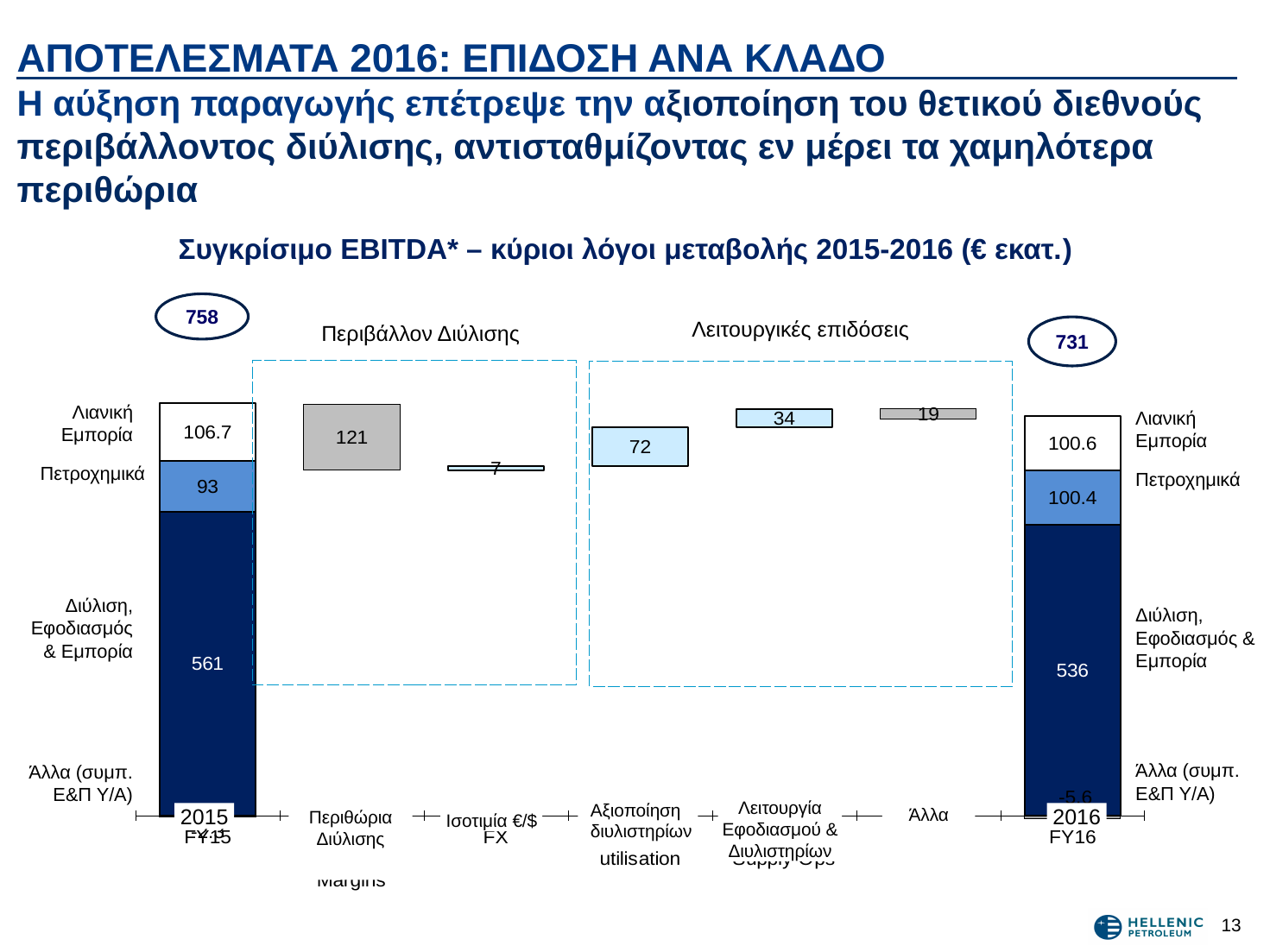
What is the value of the Διύλιση, Εφοδιασμός & Εμπορία segment in the 2016 bar? 536 Which bridge item has the smallest value? Ισοτιμία €/$ What is the value of the Πετροχημικά segment in the 2016 bar? 100.4 By how much did the Διύλιση, Εφοδιασμός & Εμπορία segment change from 2015 (561) to 2016 (536)? 25 What is the value shown for Περιθώρια Διύλισης in the bridge? 121 What is the value of the Διύλιση, Εφοδιασμός & Εμπορία segment in the 2015 bar? 561 Which bridge item has the largest value: Περιθώρια Διύλισης, Ισοτιμία €/$, Αξιοποίηση διυλιστηρίων, Λειτουργία Εφοδιασμού & Διυλιστηρίων, or Άλλα? Περιθώρια Διύλισης Which is larger: the Λιανική Εμπορία segment in 2015 or in 2016? 2015 What is the title of the chart? Συγκρίσιμο EBITDA* – κύριοι λόγοι μεταβολής 2015-2016 (€ εκατ.) What is the total comparable EBITDA shown for 2016 in the chart? 731 What is the value shown for Αξιοποίηση διυλιστηρίων? 72 What is the total comparable EBITDA shown for 2015 in the chart? 758